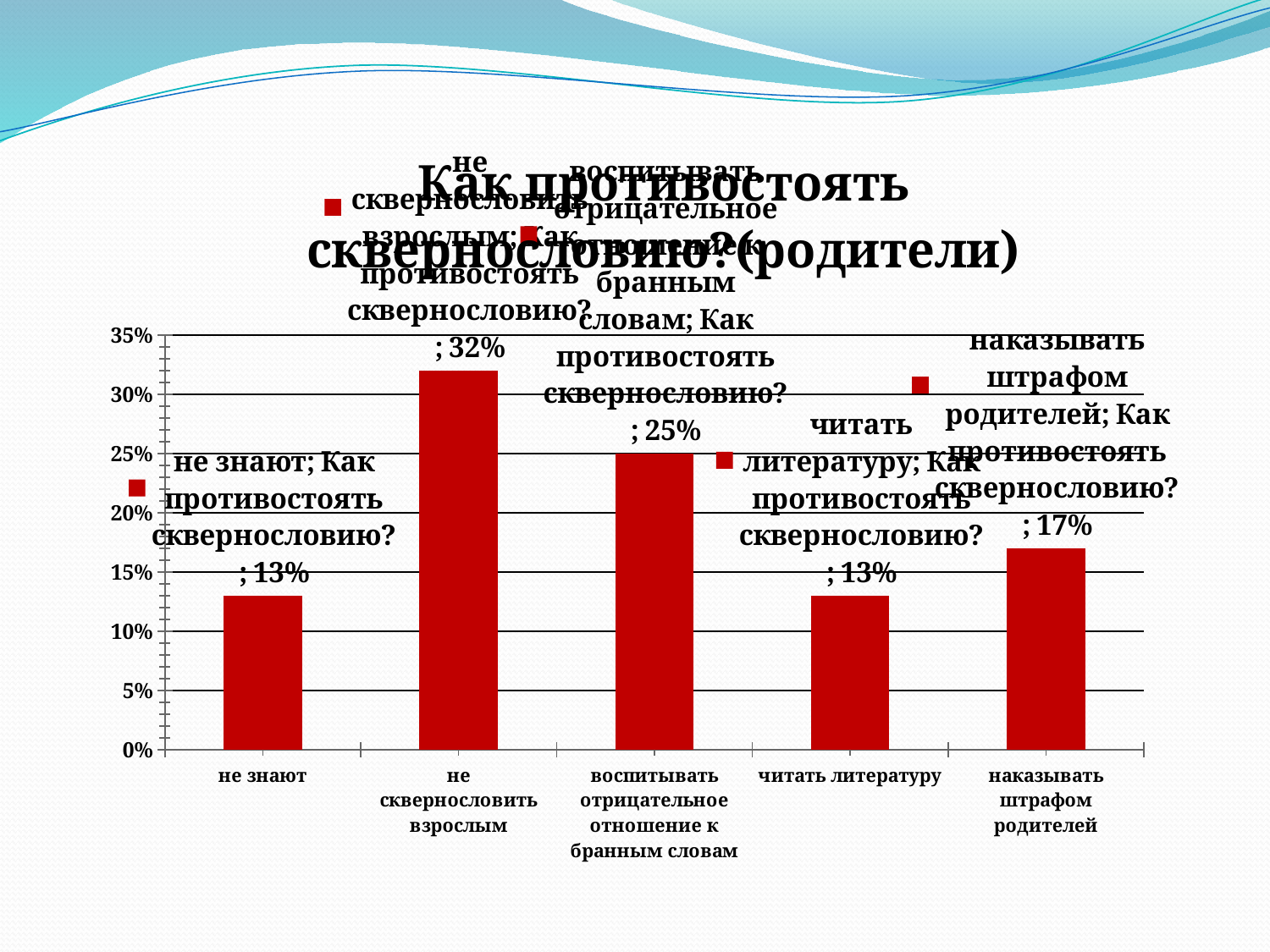
How many categories are shown on the x axis? 5 What is the value for "не знают"? 13% What is the value for "воспитывать отрицательное отношение к бранным словам"? 25% What is the value for "наказывать штрафом родителей"? 17% What is the difference between the values for "наказывать штрафом родителей" and "читать литературу"? 4% Is the value for "не сквернословить взрослым" greater or less than 30%? greater What is the difference between the values for "не сквернословить взрослым" and "воспитывать отрицательное отношение к бранным словам"? 7% What is the value for "не сквернословить взрослым"? 32% Which category has the highest value? не сквернословить взрослым What kind of chart is shown on the slide? bar chart Which is larger, the value for "воспитывать отрицательное отношение к бранным словам" or the value for "наказывать штрафом родителей"? воспитывать отрицательное отношение к бранным словам What is the title of the chart? Как противостоять сквернословию?(родители)